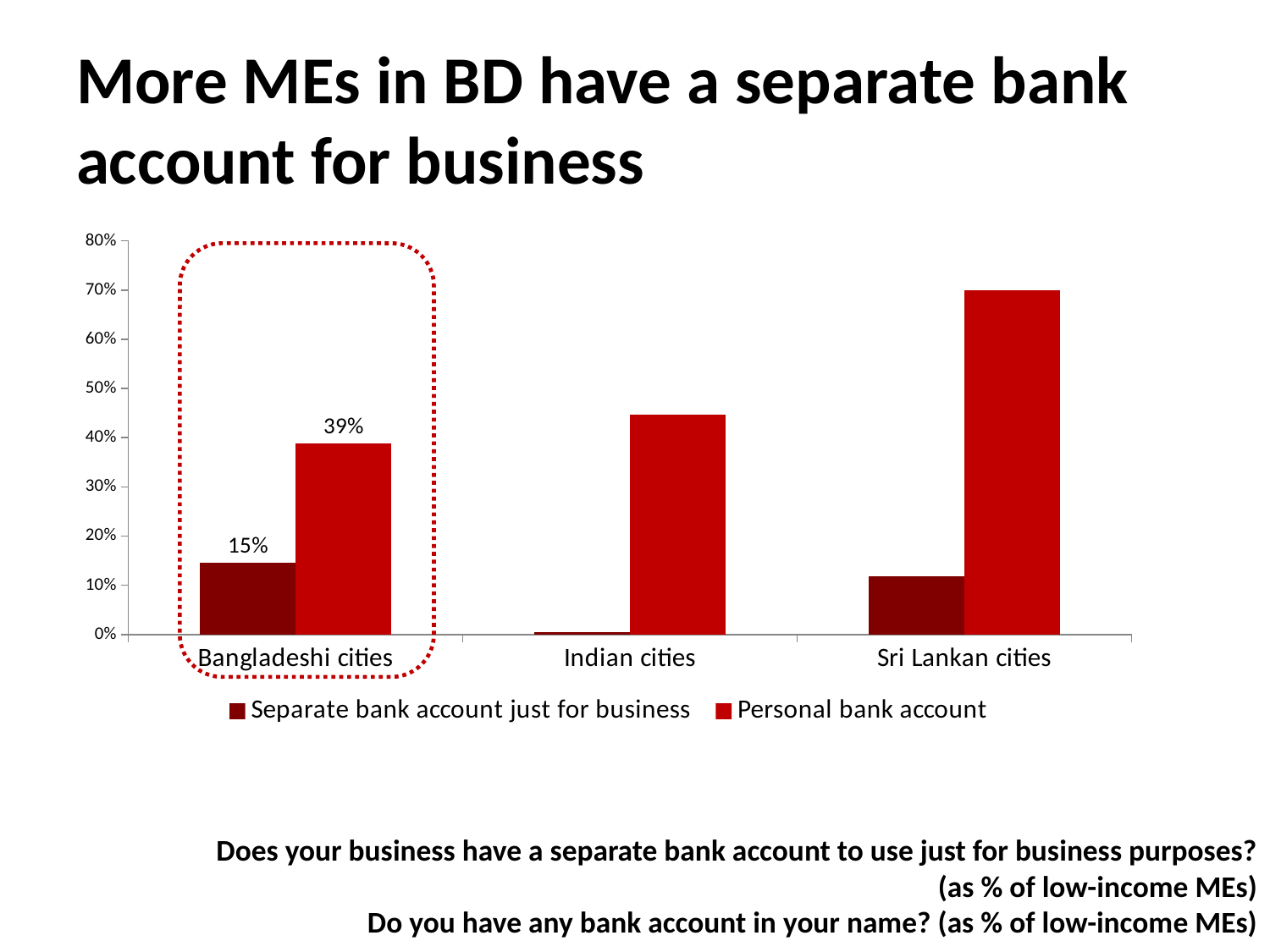
How many series does the chart legend list? 2 What percentage of MEs in Bangladeshi cities have a personal bank account? 39% What percentage of MEs in Bangladeshi cities have a separate bank account just for business? 15% Is the separate business bank account value for Sri Lankan cities greater or less than 20%? less In Bangladeshi cities, which is larger: the share with a separate bank account just for business or the share with a personal bank account? Personal bank account What type of chart is shown on the slide? Bar chart Is the personal bank account value for Indian cities greater or less than 40%? greater Which city group has the highest share of MEs with a personal bank account? Sri Lankan cities How many city groups are shown on the x axis of the chart? 3 Which city group has the lowest share of MEs with a separate bank account just for business? Indian cities Which city group has the highest share of MEs with a separate bank account just for business? Bangladeshi cities For Bangladeshi cities, what is the difference between the personal bank account share and the separate business bank account share? 24 percentage points